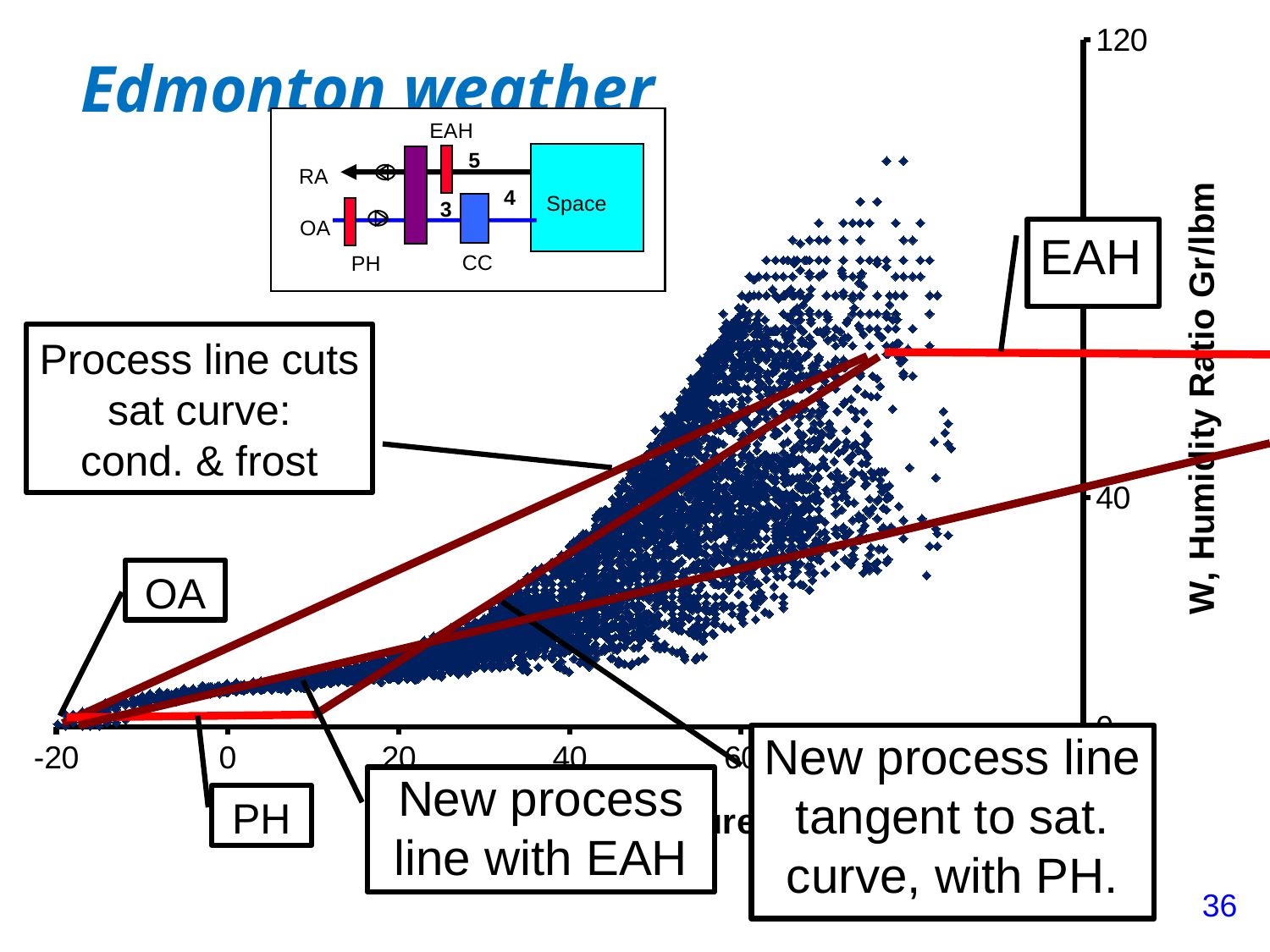
As temperature increases along the x axis, does the humidity ratio of the plotted points generally rise or fall? rise Is the humidity ratio of the red EAH line greater or less than 40? greater What kind of chart is shown on the slide? scatter chart Is the humidity ratio at the PH point greater or less than 40? less What is the label on the vertical axis of the chart? W, Humidity Ratio Gr/lbm What is the title of the chart? Edmonton weather Is the humidity ratio at the OA point greater or less than 40? less